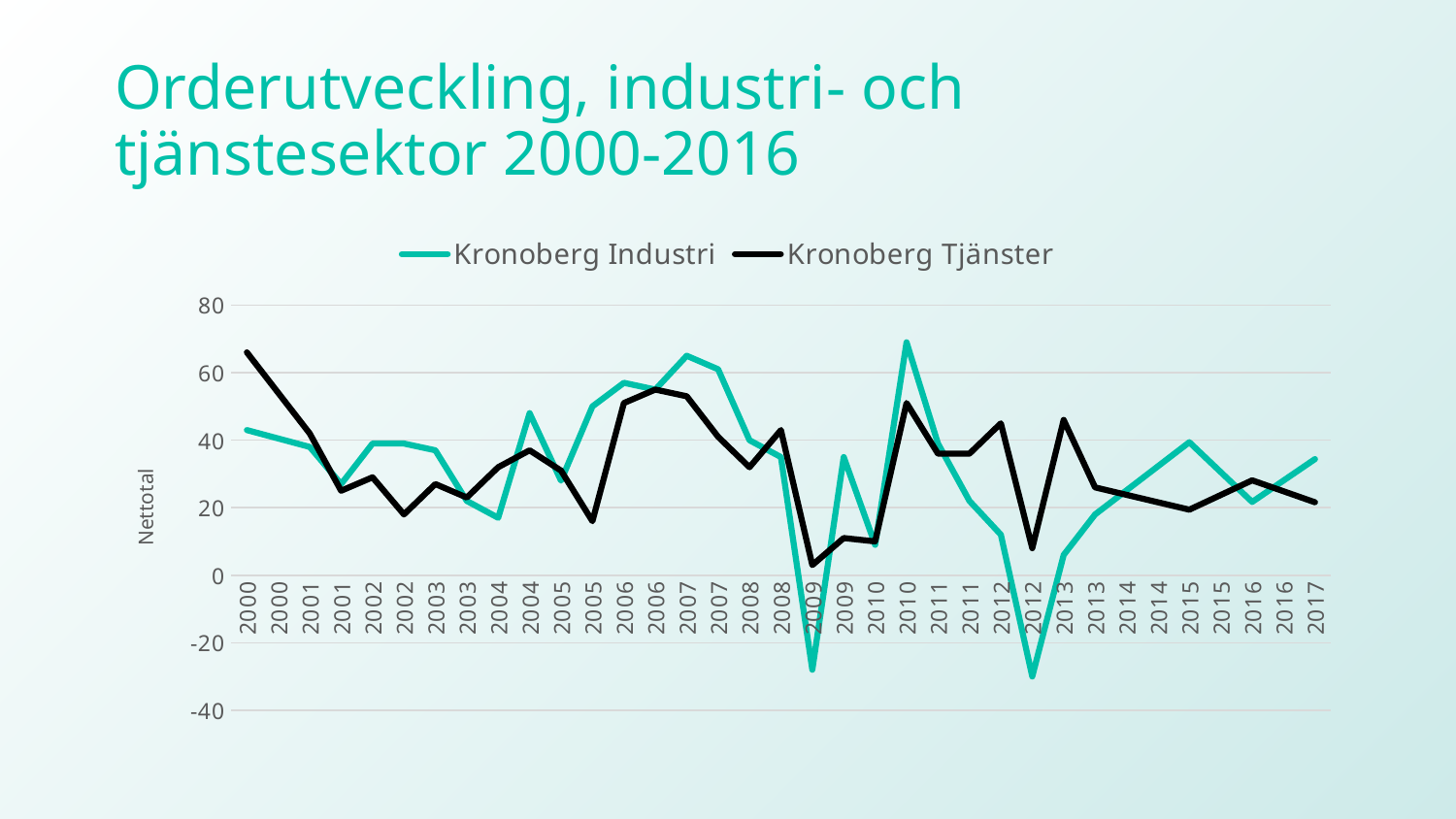
What are the two series named in the legend? Kronoberg Industri and Kronoberg Tjänster At the first 2000 point, which series has the higher value, Kronoberg Industri or Kronoberg Tjänster? Kronoberg Tjänster Is the value for Kronoberg Industri at the second 2010 point greater or less than 60? greater How many points are labelled along the x axis? 35 How many series does the legend list? 2 Is the value for Kronoberg Industri at the second 2009 point greater or less than -20? greater Is the value for Kronoberg Tjänster at the second 2012 point greater or less than 20? less At the second 2010 point, which series has the higher value, Kronoberg Industri or Kronoberg Tjänster? Kronoberg Industri At which x-axis point does Kronoberg Tjänster reach its highest value? 2000 (first point) What is the label on the vertical axis? Nettotal What kind of chart is shown on the slide? Line chart